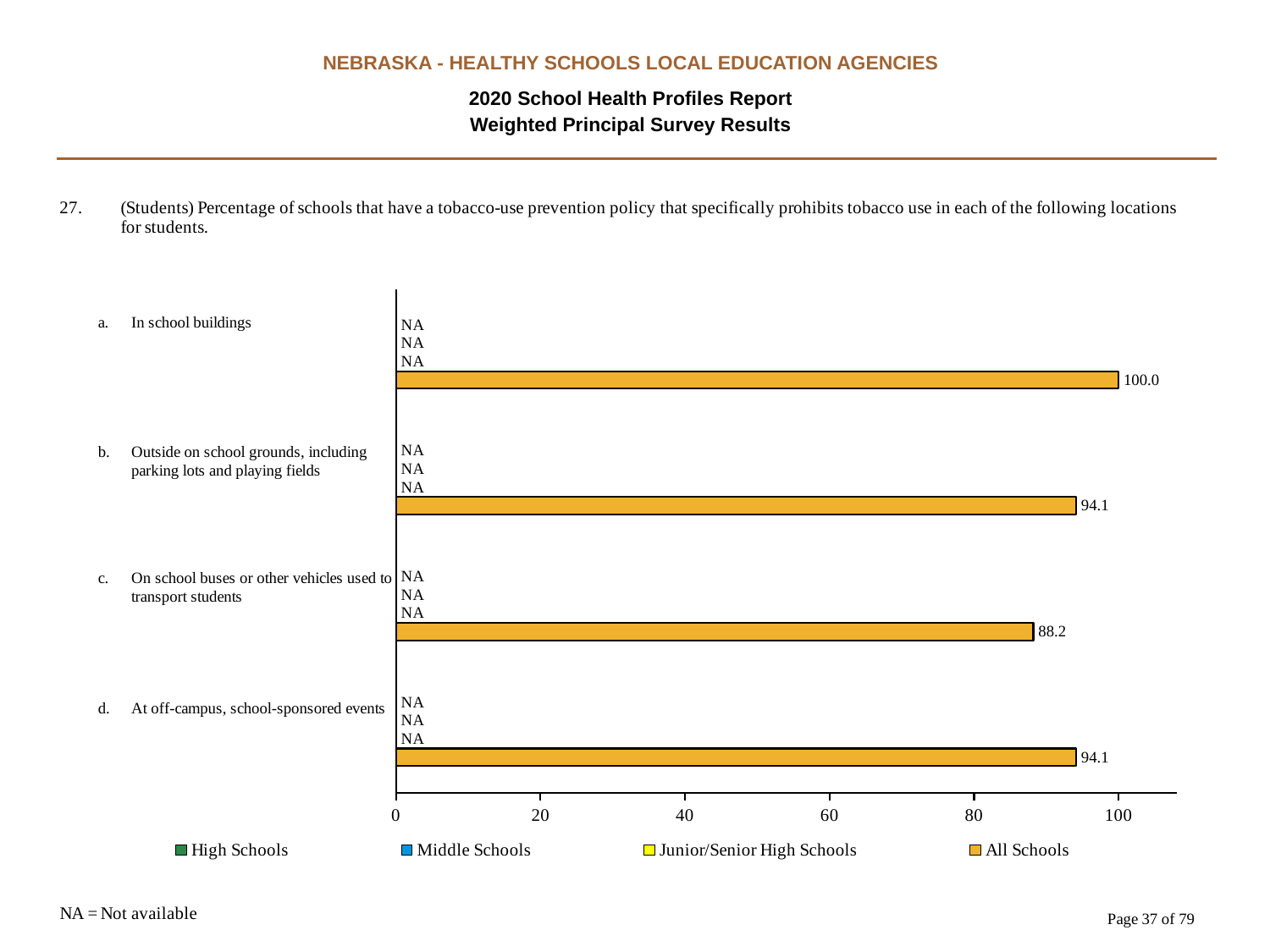
What kind of chart is shown on the slide? Bar chart What is the All Schools value for 'Outside on school grounds, including parking lots and playing fields'? 94.1 How many series does the legend list? 4 Which location has the lowest All Schools value? On school buses or other vehicles used to transport students What value is shown for High Schools for 'In school buildings'? NA What is the difference between the All Schools values for 'In school buildings' and 'On school buses or other vehicles used to transport students'? 11.8 What is the All Schools value for 'In school buildings'? 100.0 Which location has the highest All Schools value? In school buildings How many locations (categories) are shown in the chart? 4 Which is larger for All Schools: 'Outside on school grounds, including parking lots and playing fields' or 'On school buses or other vehicles used to transport students'? Outside on school grounds, including parking lots and playing fields What is the All Schools value for 'At off-campus, school-sponsored events'? 94.1 What is the All Schools value for 'On school buses or other vehicles used to transport students'? 88.2